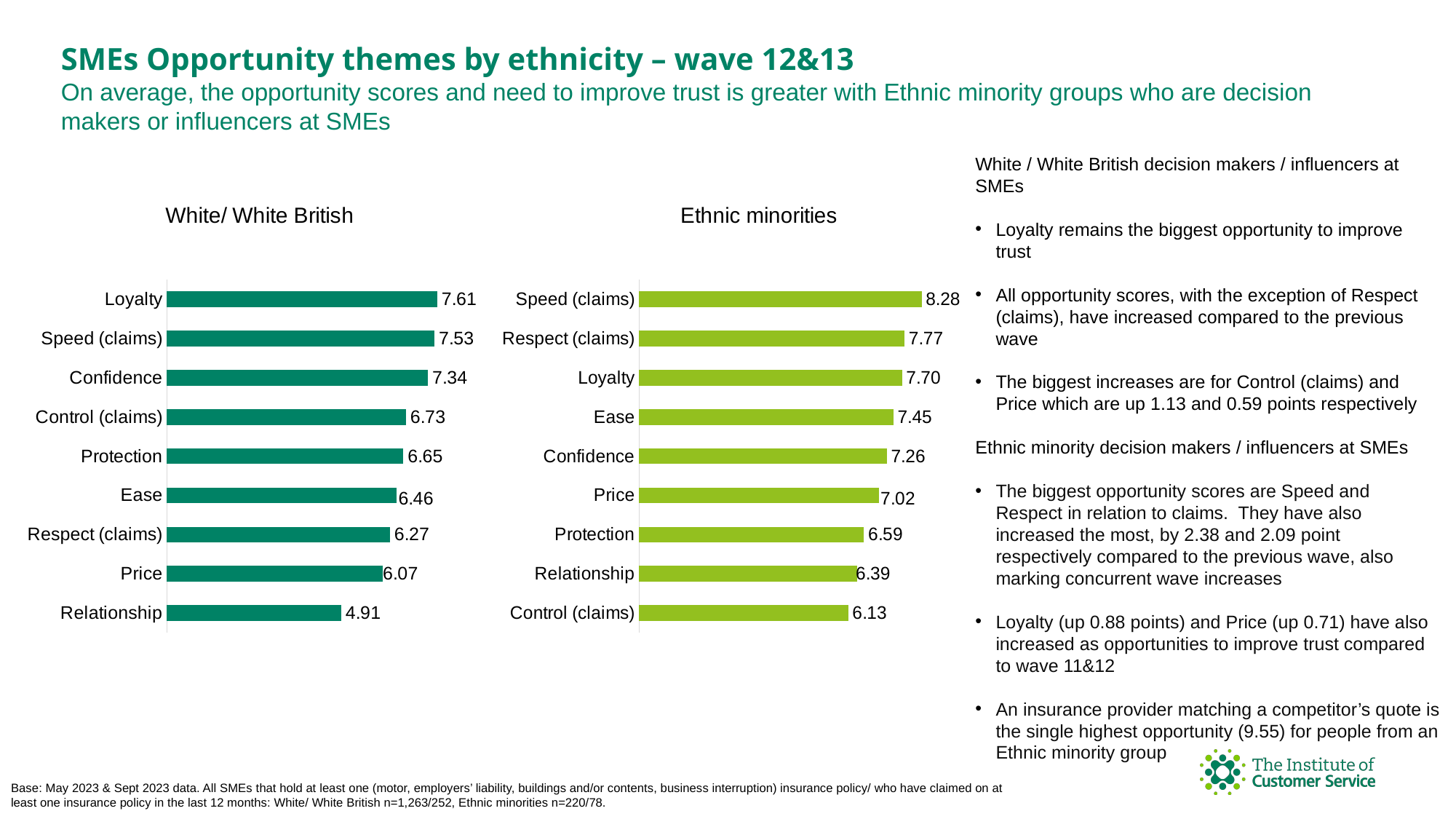
What type of chart is the 'White/ White British' chart? Bar chart In the 'Ethnic minorities' chart, which category has the highest value? Speed (claims) In the 'Ethnic minorities' chart, which category has the lowest value? Control (claims) In the 'White/ White British' chart, which is larger: Confidence or Control (claims)? Confidence In the 'Ethnic minorities' chart, what is the value for Speed (claims)? 8.28 How many categories are shown in the 'Ethnic minorities' chart? 9 In the 'White/ White British' chart, what is the value for Loyalty? 7.61 In the 'White/ White British' chart, which category has the lowest value? Relationship In the 'White/ White British' chart, what is the difference between Loyalty and Relationship? 2.70 Which is larger: Price in the 'White/ White British' chart or Price in the 'Ethnic minorities' chart? Price in the 'Ethnic minorities' chart In the 'Ethnic minorities' chart, what is the value for Relationship? 6.39 In the 'Ethnic minorities' chart, what is the difference between Speed (claims) and Control (claims)? 2.15